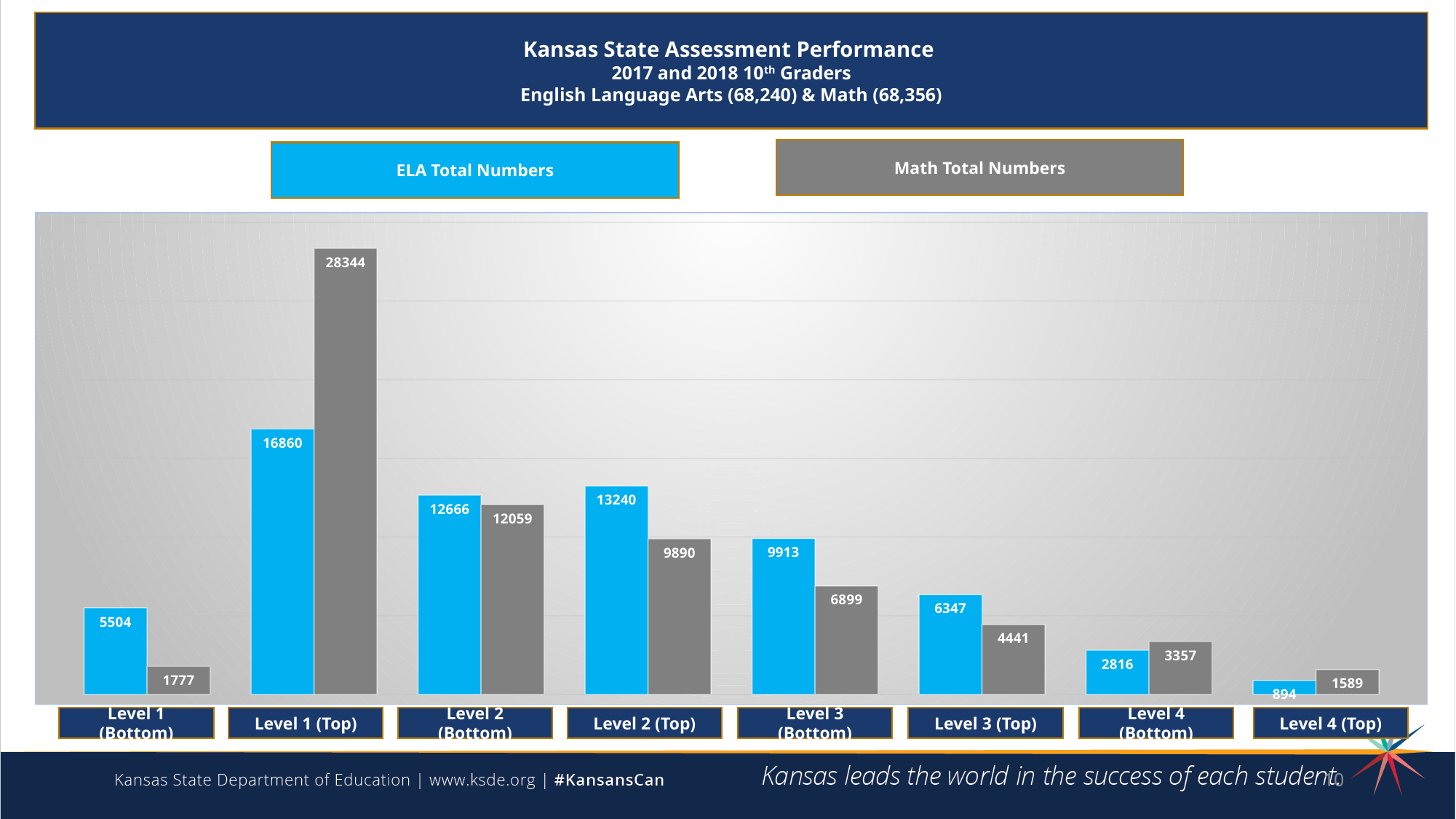
What is the ELA Total Numbers value for Level 1 (Top)? 16860 For Level 2 (Top), which is larger: the ELA value or the Math value? ELA For Level 4 (Bottom), which is larger: the ELA value or the Math value? Math How many series does the chart show? 2 What is the Math Total Numbers value for Level 2 (Bottom)? 12059 Which category has the lowest ELA Total Numbers value? Level 4 (Top) What type of chart is shown on the slide? Bar chart What is the difference between the ELA and Math values for Level 3 (Bottom)? 3014 Which category has the highest Math Total Numbers value? Level 1 (Top) How many categories are shown on the x axis of the chart? 8 What is the ELA Total Numbers value for Level 4 (Top)? 894 What is the difference between the Math and ELA values for Level 1 (Top)? 11484